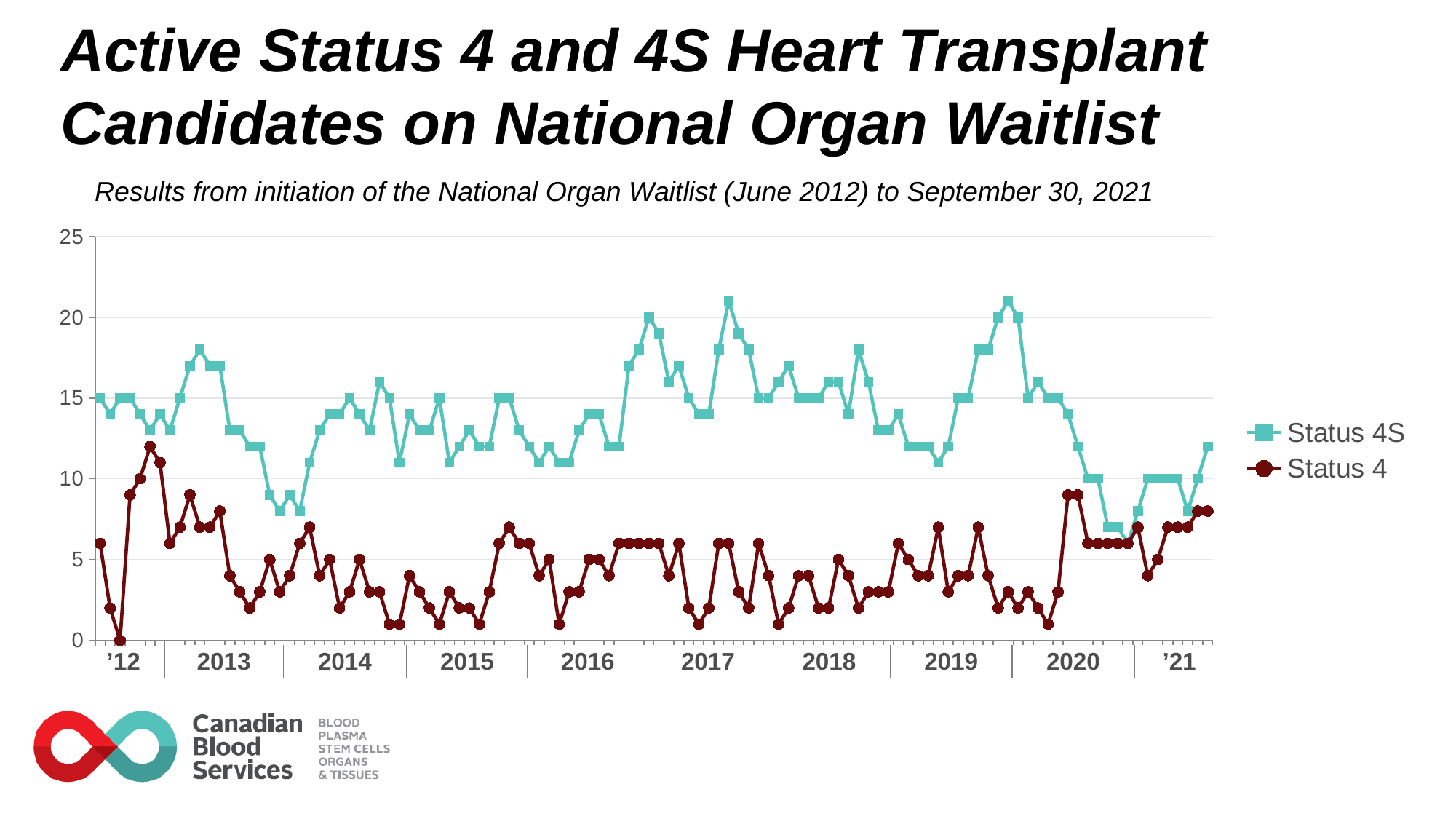
Is the peak value of the Status 4 line in 2012 greater or less than 10? greater What is the lowest value reached by the Status 4 line? 0 What are the two series named in the legend? Status 4S and Status 4 Does the Status 4S line rise or fall between its 2019 peak and mid-2020? fall Is the peak value of the Status 4S line in 2017 greater or less than 20? greater What kind of chart is shown on the slide? line chart Is the lowest value of the Status 4S line in 2020 greater or less than 10? less How many series does the legend list? 2 Which series has the higher values across the whole period, Status 4S or Status 4? Status 4S Which series is drawn in teal with square markers? Status 4S Does the Status 4S line rise or fall from mid-2020 to the end of the series in 2021? rise How many year labels are shown on the x axis? 10